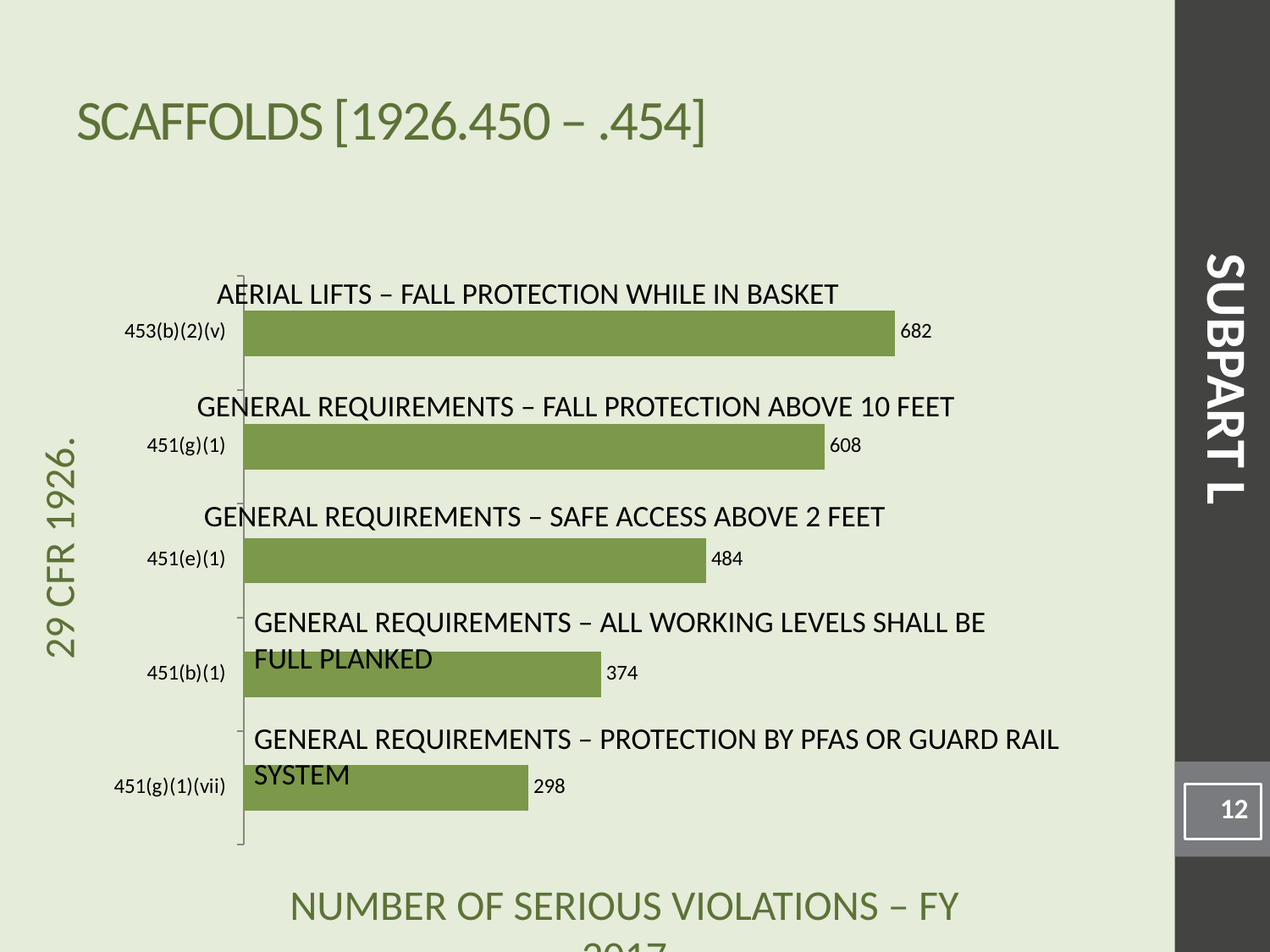
What is the number of serious violations for 453(b)(2)(v)? 682 How many categories are shown in the chart? 5 Which has more serious violations, 451(b)(1) or 451(g)(1)(vii)? 451(b)(1) What is the number of serious violations for 451(g)(1)? 608 What is the number of serious violations for 451(b)(1)? 374 What is the difference between the values for 451(e)(1) and 451(b)(1)? 110 Which category has the highest number of serious violations? 453(b)(2)(v) What is the difference between the values for 453(b)(2)(v) and 451(g)(1)? 74 What is the number of serious violations for 451(e)(1)? 484 What is the number of serious violations for 451(g)(1)(vii)? 298 What kind of chart is shown on the slide? Bar chart Which category has the lowest number of serious violations? 451(g)(1)(vii)